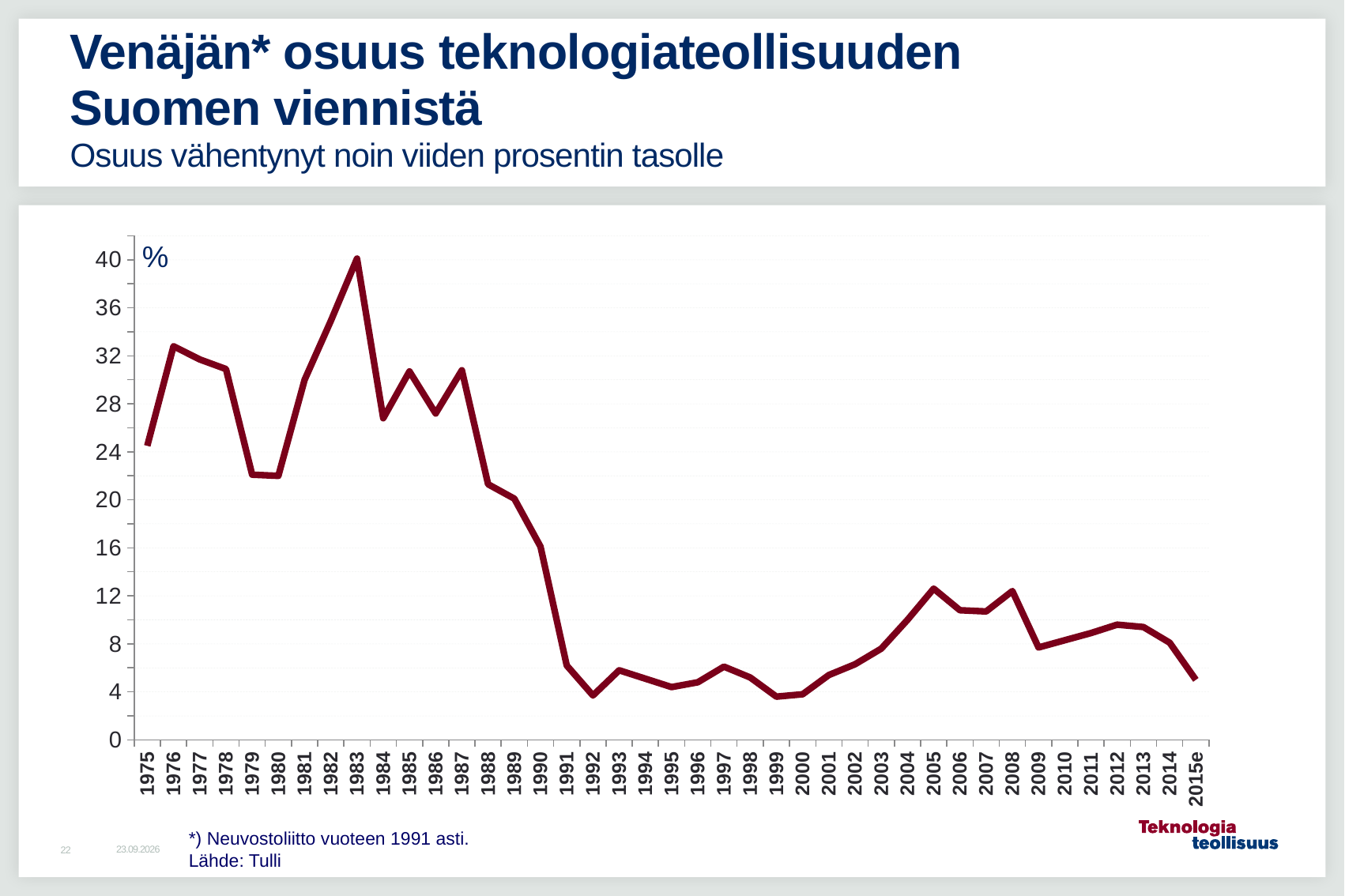
How many years are plotted on the x axis? 41 Is the value for 1983 greater or less than 36? greater What kind of chart is shown on the slide? line chart Is the value for 1991 greater or less than 8? less What unit is shown at the top of the y axis? % Which year has the larger value, 2008 or 2015e? 2008 In which year does the line reach its highest value? 1983 Is the value for 1975 greater or less than 20? greater Does the value rise or fall from 2000 to 2005? rise Which year has the larger value, 1976 or 2005? 1976